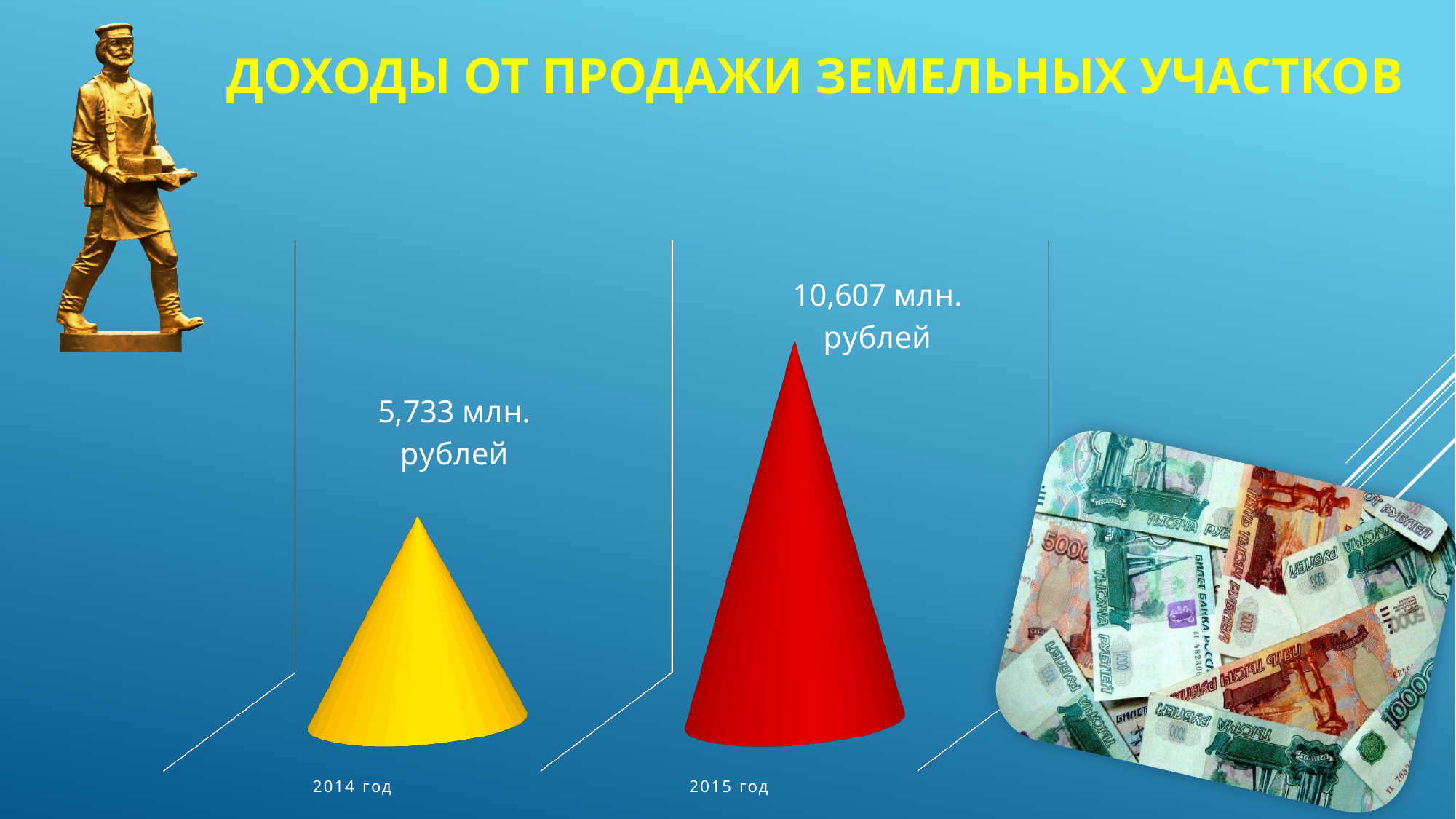
Which is larger, the value for 2014 год or the value for 2015 год? 2015 год What is the value shown for 2015 год? 10,607 млн. рублей What is the difference between the values for 2015 год and 2014 год? 4,874 млн. рублей Which year has the highest income from land plot sales? 2015 год Do the values rise or fall from 2014 год to 2015 год? rise Which year has the lowest income from land plot sales? 2014 год What kind of chart is shown on the slide? bar chart What colour is the bar for 2015 год? red How many categories (years) are shown in the chart? 2 What is the value shown for 2014 год? 5,733 млн. рублей What is the title of the slide? ДОХОДЫ ОТ ПРОДАЖИ ЗЕМЕЛЬНЫХ УЧАСТКОВ